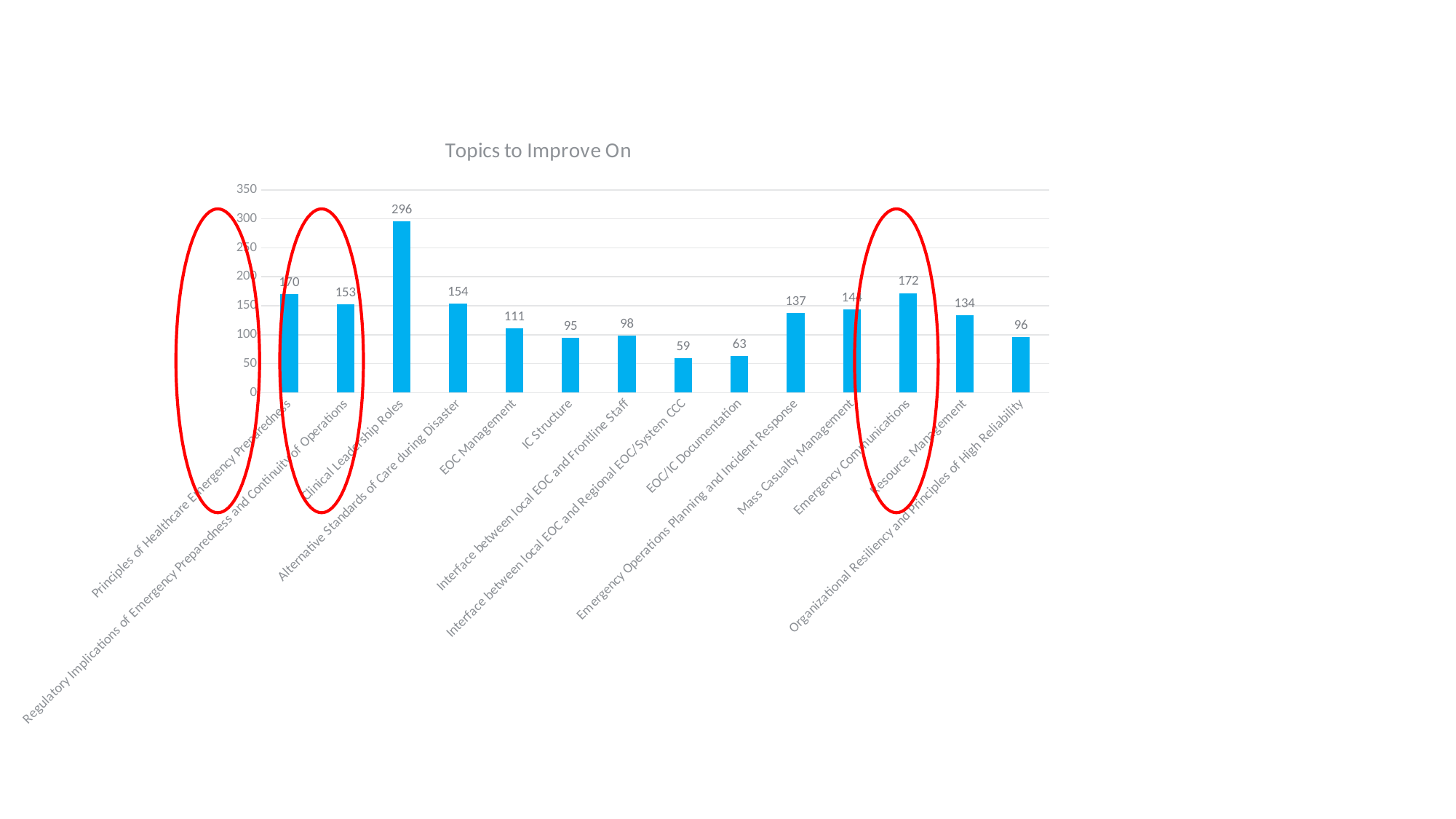
What is the value for EOC/IC Documentation? 63 How many topics are shown in the chart? 14 Which is larger, the value for EOC Management or the value for IC Structure? EOC Management What is the difference between the values for Clinical Leadership Roles and Emergency Communications? 124 Which topic has the highest value? Clinical Leadership Roles Is the value for Emergency Operations Planning and Incident Response greater or less than 100? greater What is the title of the chart? Topics to Improve On What is the value for Emergency Communications? 172 What is the value for Resource Management? 134 What kind of chart is this? Bar chart What is the value for Clinical Leadership Roles? 296 Which topic has the lowest value? Interface between local EOC and Regional EOC/System CCC